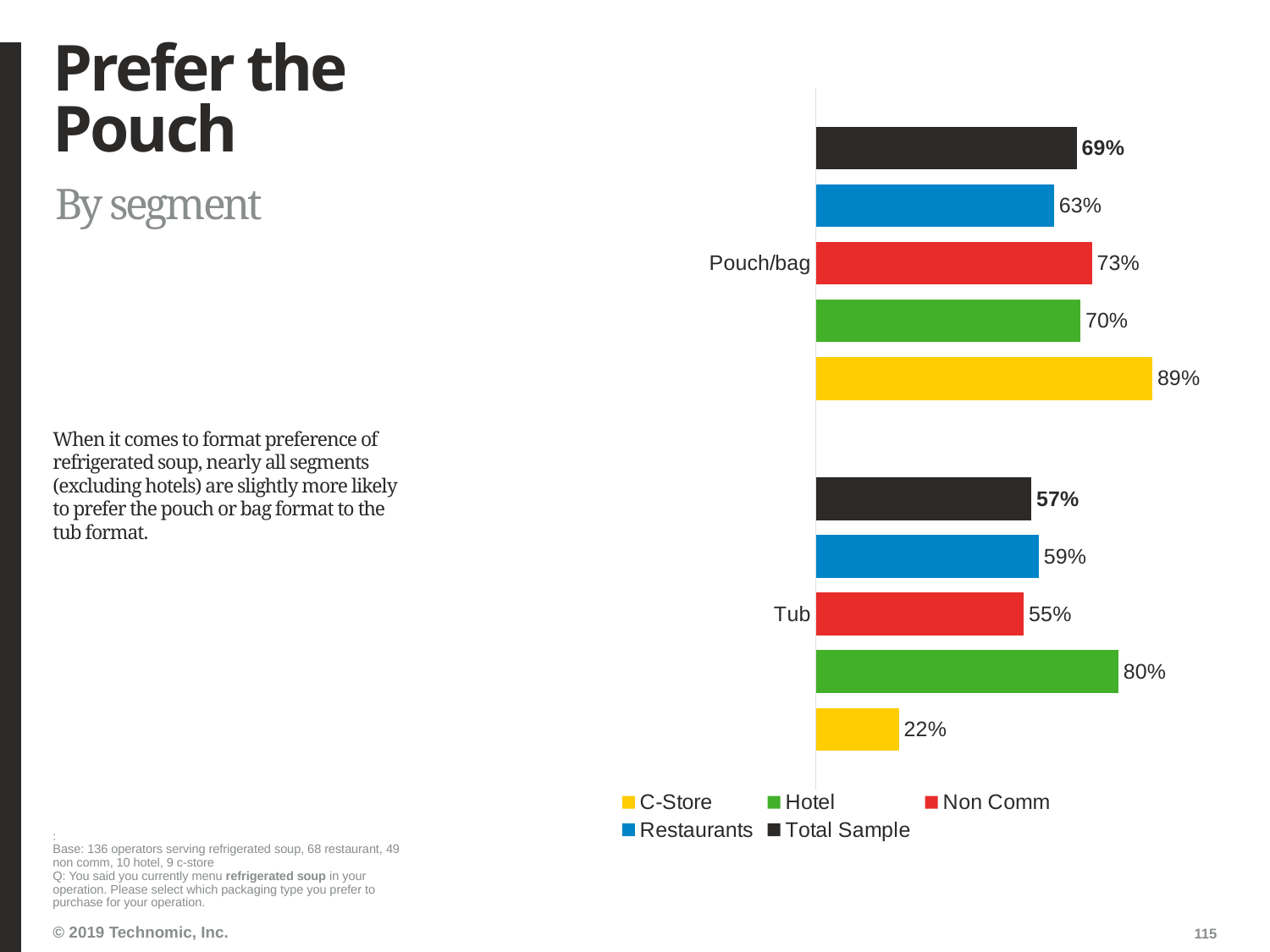
What is the Non Comm value for Pouch/bag? 73% Which colour represents the Hotel series in the legend? Green What is the Total Sample value for Tub? 57% What percentage of C-Store operators prefer the Pouch/bag format? 89% How many series does the legend list? 5 Which segment has the lowest value for Tub? C-Store Which segment has the highest value for Pouch/bag? C-Store What is the Hotel value for Tub? 80% What is the difference between the C-Store values for Pouch/bag and Tub? 67 percentage points How many categories are shown on the chart? 2 What kind of chart is shown on the slide? Bar chart Which is larger for Restaurants: the Pouch/bag value or the Tub value? Pouch/bag